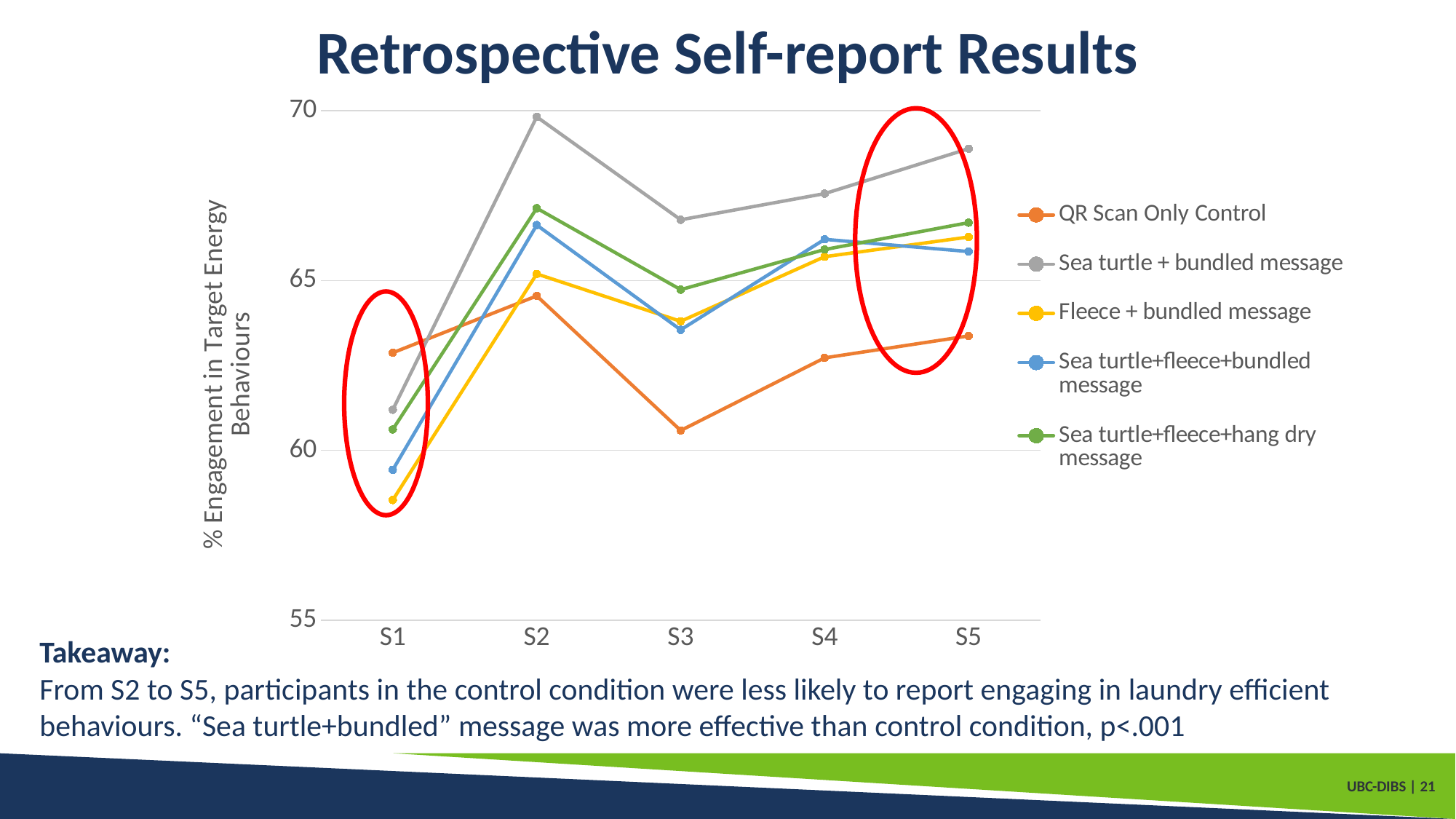
How many points are there along the x axis? 5 Is the value for Sea turtle + bundled message at S2 greater or less than 65? greater At S5, which is larger: Sea turtle + bundled message or QR Scan Only Control? Sea turtle + bundled message What kind of chart is shown on the slide? line chart How many series does the legend list? 5 Is the value for Fleece + bundled message at S1 greater or less than 60? less What is the label on the y axis? % Engagement in Target Energy Behaviours Which series has the lowest value at S1? Fleece + bundled message Which series has the lowest value at S5? QR Scan Only Control Is the value for QR Scan Only Control at S3 greater or less than 65? less Which series has the highest value at S2? Sea turtle + bundled message Does the QR Scan Only Control series rise or fall from S1 to S2? rise